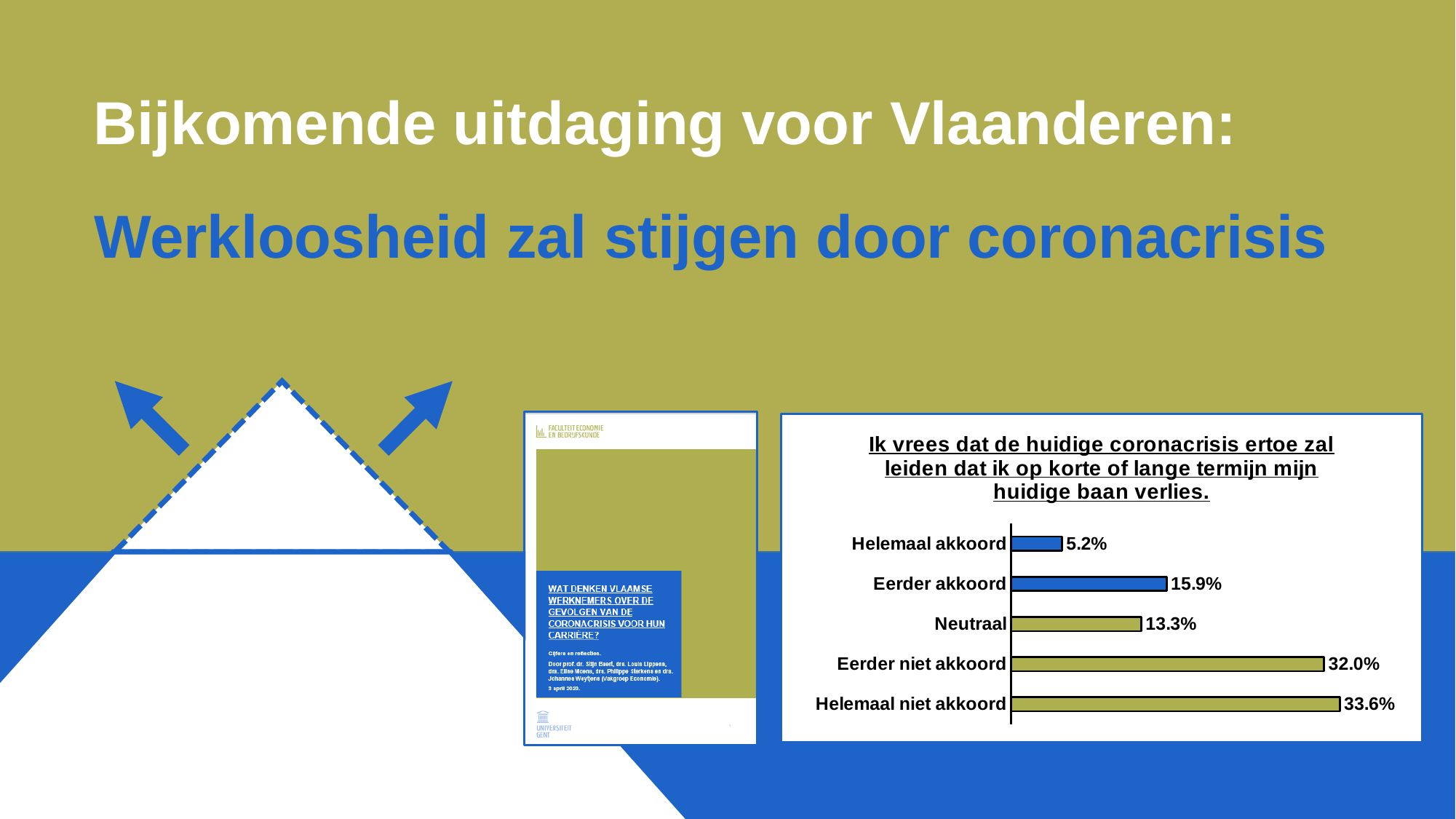
How many categories are shown in the chart? 5 What is the title of the chart? Ik vrees dat de huidige coronacrisis ertoe zal leiden dat ik op korte of lange termijn mijn huidige baan verlies. Which is larger, 'Eerder akkoord' or 'Neutraal'? Eerder akkoord What kind of chart is shown on the slide? Bar chart What is the value for 'Neutraal'? 13.3% What is the difference between 'Helemaal niet akkoord' and 'Eerder niet akkoord'? 1.6% What is the value for 'Helemaal akkoord'? 5.2% What is the value for 'Helemaal niet akkoord'? 33.6% What is the value for 'Eerder akkoord'? 15.9% Which category has the lowest value? Helemaal akkoord What is the difference between 'Eerder akkoord' and 'Helemaal akkoord'? 10.7% Which category has the highest value? Helemaal niet akkoord